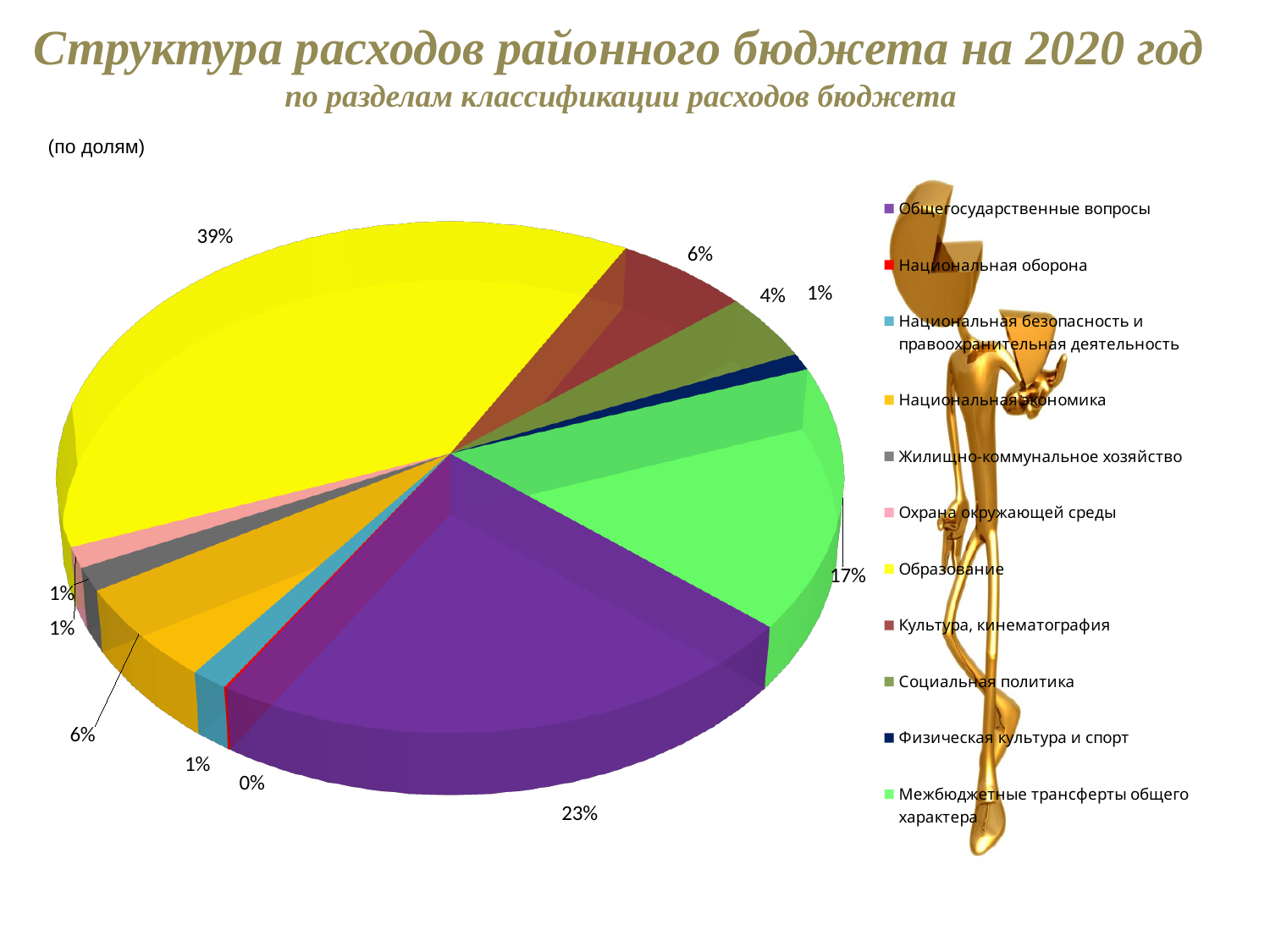
What is the difference in share between Образование and Общегосударственные вопросы? 16% Which has a larger share: Межбюджетные трансферты общего характера or Национальная экономика? Межбюджетные трансферты общего характера What share of the district budget expenditure goes to Образование? 39% What share is shown for Общегосударственные вопросы? 23% How many sections are listed in the chart legend? 11 What share is shown for Культура, кинематография? 6% What type of chart is shown on the slide? pie chart Which section has the largest share of the budget expenditure? Образование What share is shown for Национальная оборона? 0% What share is shown for Межбюджетные трансферты общего характера? 17% Which section has the smallest share of the budget expenditure? Национальная оборона What share is shown for Социальная политика? 4%